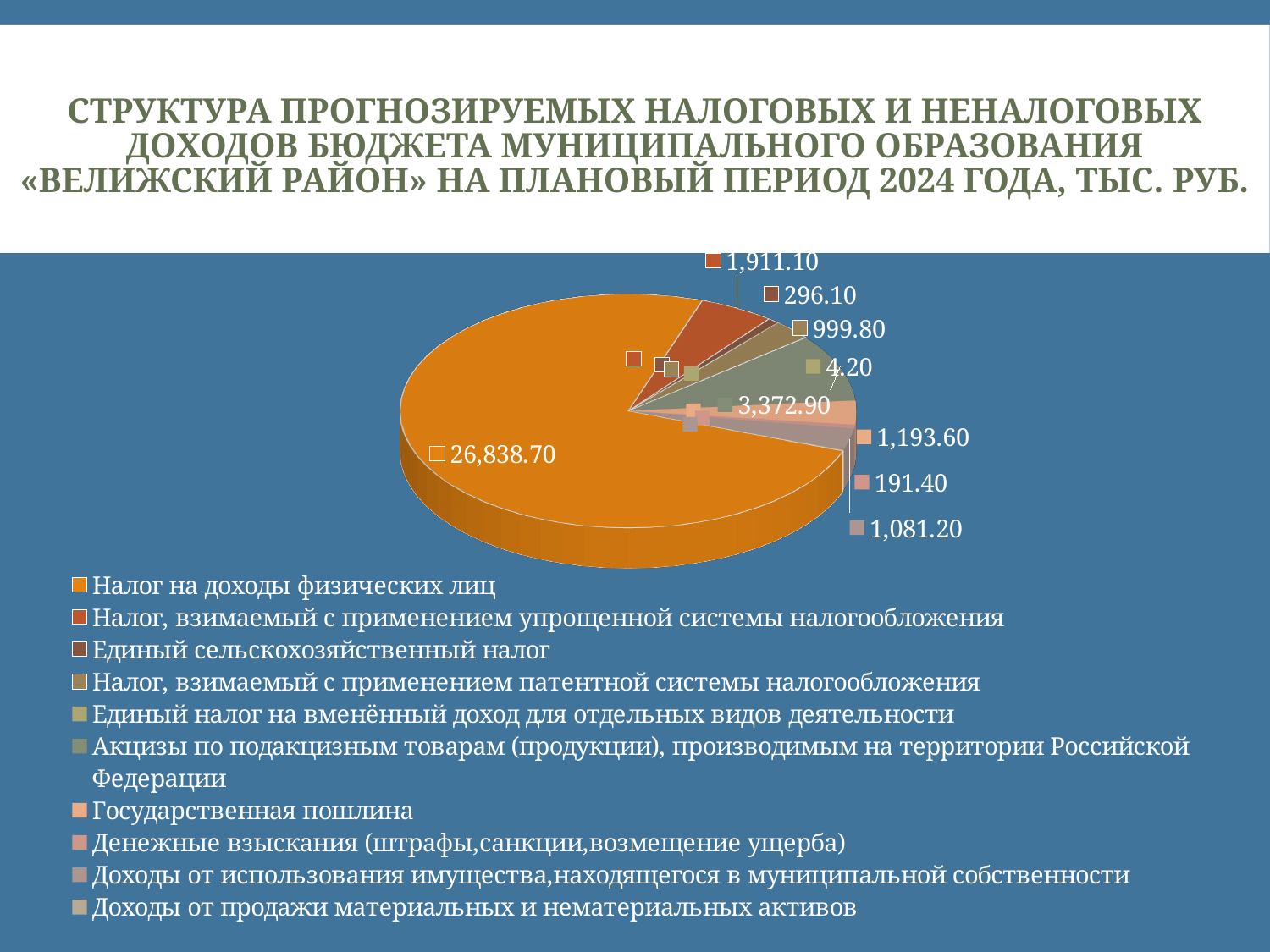
Which category has the largest slice of the pie? Налог на доходы физических лиц What value is shown for Акцизы по подакцизным товарам (продукции), производимым на территории Российской Федерации? 3,372.90 In what units are the values in the chart expressed, according to the slide title? тыс. руб. What is the difference between the value 1,911.10 and the value 296.10 shown on the chart? 1,615.00 What value is shown for Налог на доходы физических лиц? 26,838.70 Which is larger: the value for Налог, взимаемый с применением упрощенной системы налогообложения, or the value for Налог, взимаемый с применением патентной системы налогообложения? Налог, взимаемый с применением упрощенной системы налогообложения What value is shown for Государственная пошлина? 1,193.60 How many categories does the legend of the pie chart list? 10 What kind of chart is shown on the slide? pie chart What is the difference between the value for Государственная пошлина (1,193.60) and the value for Доходы от использования имущества, находящегося в муниципальной собственности (1,081.20)? 112.40 What value is shown for Единый сельскохозяйственный налог? 296.10 What is the smallest value printed as a data label on the pie chart? 4.20